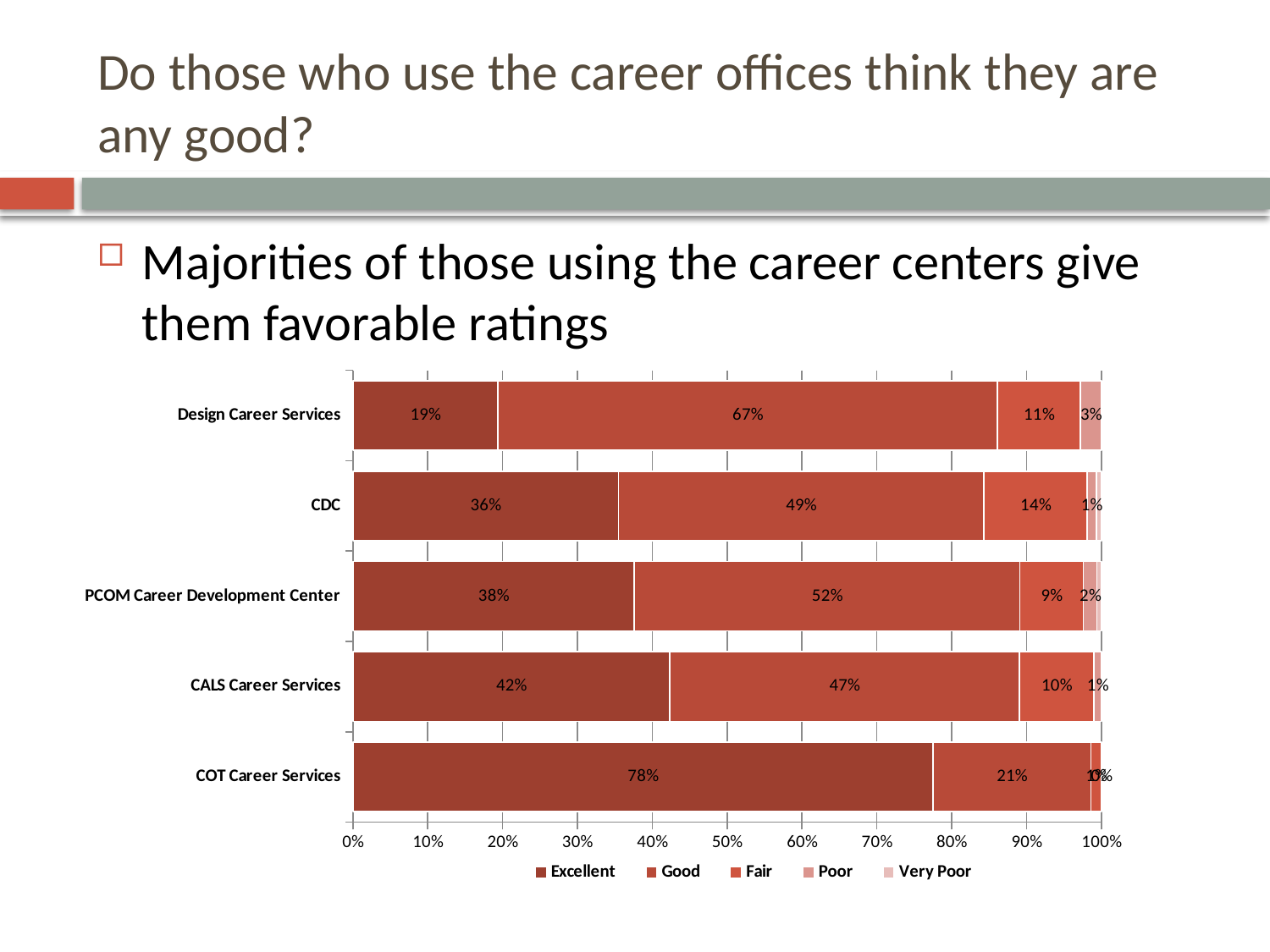
What is the Excellent rating percentage for PCOM Career Development Center? 38% Which career office has the highest Excellent rating? COT Career Services What is the Fair rating percentage for CDC? 14% What is the Good rating percentage for Design Career Services? 67% Which is larger: the Good rating for CDC or the Good rating for PCOM Career Development Center? PCOM Career Development Center How many career offices (categories) are plotted in the chart? 5 What is the difference between the Excellent ratings of CALS Career Services and CDC? 6% Which series is listed first in the chart legend? Excellent How many series does the chart legend list? 5 What kind of chart is shown on the slide? stacked bar chart Which career office has the lowest Excellent rating? Design Career Services What percentage of COT Career Services users rated it Excellent? 78%